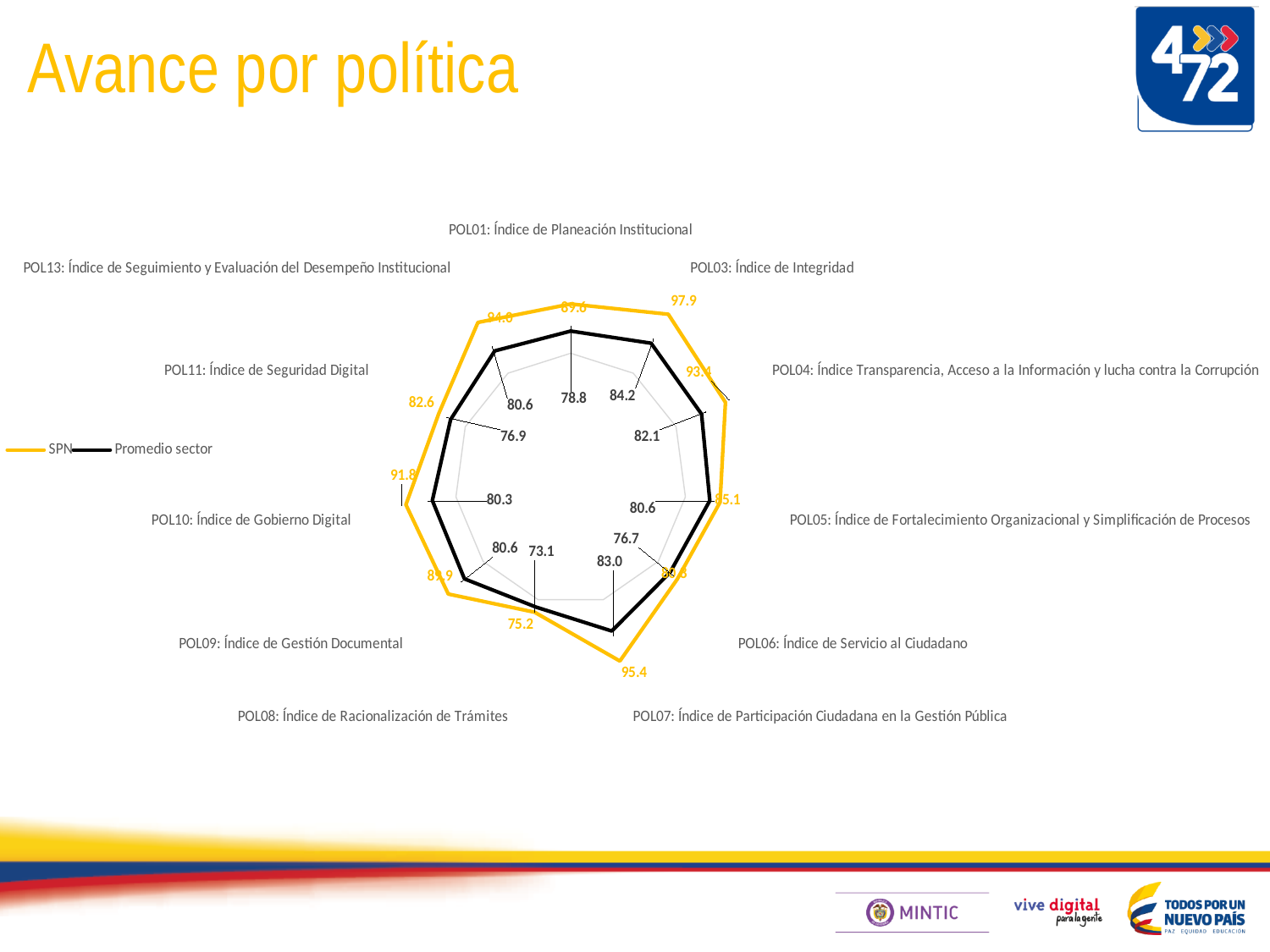
What is the SPN value for POL08: Índice de Racionalización de Trámites? 75.2 Which series is drawn in yellow? SPN Which policy has the highest SPN value? POL03: Índice de Integridad What is the Promedio sector value for POL07: Índice de Participación Ciudadana en la Gestión Pública? 83.0 What kind of chart is shown on the slide? Radar chart What is the Promedio sector value for POL01: Índice de Planeación Institucional? 78.8 Which policy has the lowest Promedio sector value? POL08: Índice de Racionalización de Trámites What is the SPN value for POL03: Índice de Integridad? 97.9 What is the difference between the SPN and Promedio sector values for POL03: Índice de Integridad? 13.7 How many series does the legend list? 2 How many policy categories (axes) does the radar chart have? 11 Which is larger, the SPN value for POL03: Índice de Integridad or the SPN value for POL07: Índice de Participación Ciudadana en la Gestión Pública? POL03: Índice de Integridad